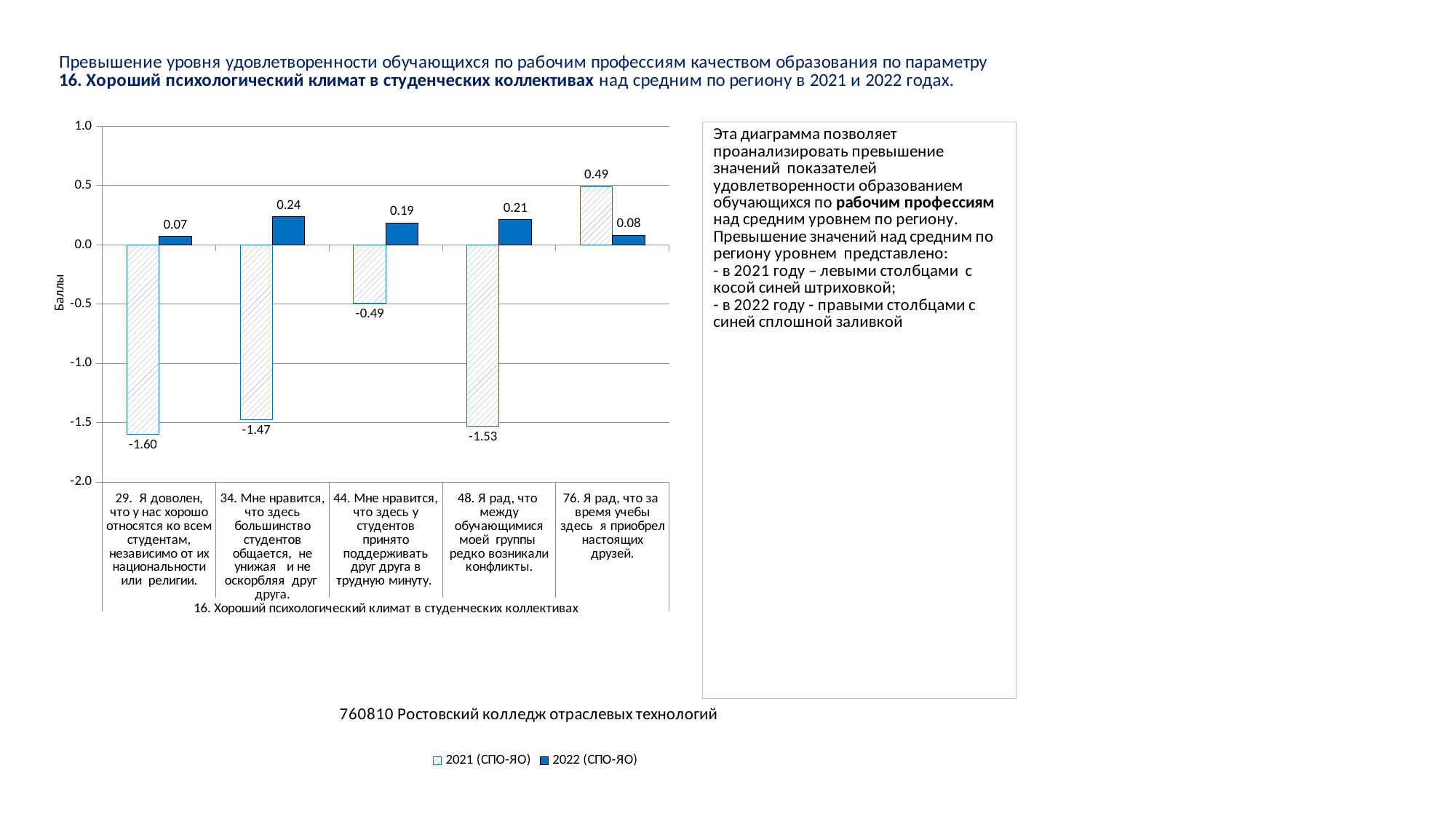
How many categories are shown on the x axis of the chart? 5 What is the label of the y axis of the chart? Баллы For category 76, which is larger: the 2021 (СПО-ЯО) value or the 2022 (СПО-ЯО) value? 2021 (СПО-ЯО) What is the difference between the 2022 and 2021 values for category 48 (Я рад, что между обучающимися моей группы редко возникали конфликты)? 1.74 How many series does the chart legend list? 2 Which category has the lowest 2021 (СПО-ЯО) value? 29. Я доволен, что у нас хорошо относятся ко всем студентам, независимо от их национальности или религии. Which category has the highest 2022 (СПО-ЯО) value? 34. Мне нравится, что здесь большинство студентов общается, не унижая и не оскорбляя друг друга. What type of chart is shown on the slide? Bar chart What is the 2021 (СПО-ЯО) value for category 76 (Я рад, что за время учебы здесь я приобрел настоящих друзей)? 0.49 What is the 2021 (СПО-ЯО) value for category 29 (Я доволен, что у нас хорошо относятся ко всем студентам)? -1.60 What is the 2022 (СПО-ЯО) value for category 44 (Мне нравится, что здесь у студентов принято поддерживать друг друга в трудную минуту)? 0.19 What is the 2022 (СПО-ЯО) value for category 34 (Мне нравится, что здесь большинство студентов общается, не унижая и не оскорбляя друг друга)? 0.24